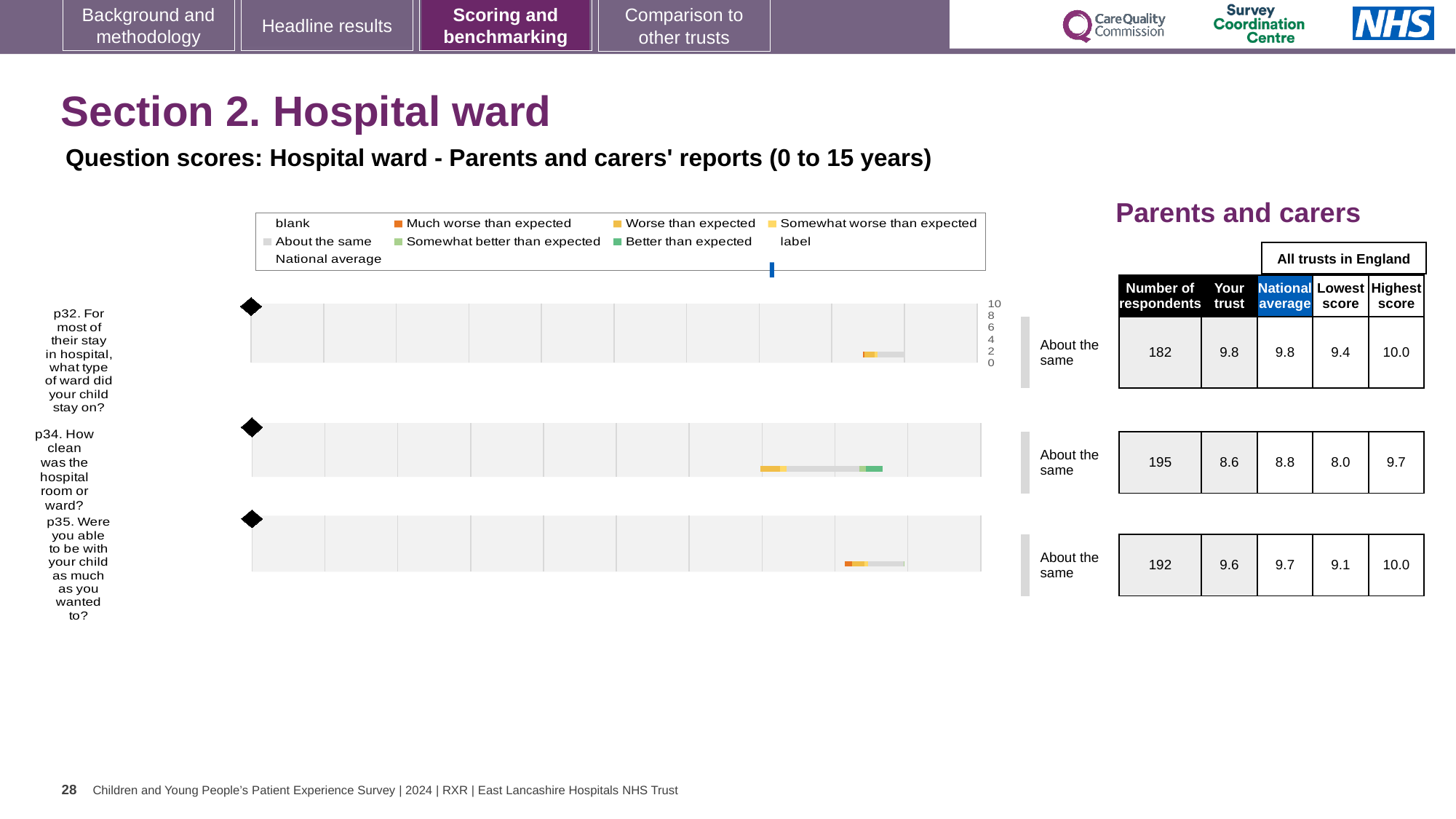
Which of the three questions (p32, p34, p35) has the lowest 'Your trust' score? p34 What benchmark category label is shown next to the p34 chart? About the same For the p34 chart (how clean was the hospital room or ward), what is the 'Your trust' score? 8.6 For the p35 chart (were you able to be with your child as much as you wanted to), what is the national average score? 9.7 For the p32 chart, what is the lowest score among all trusts in England? 9.4 For the p34 chart, what is the highest score among all trusts in England? 9.7 What kind of chart is used for each question row (p32, p34, p35)? bar chart How many question charts are shown on the slide? 3 Which of the three questions (p32, p34, p35) has the most respondents? p34 For the p34 chart, what is the difference between the national average and the 'Your trust' score? 0.2 For the p32 chart (what type of ward did your child stay on), what is the number of respondents shown in the table? 182 Is the 'Your trust' score for p32 higher or lower than the 'Your trust' score for p35? higher